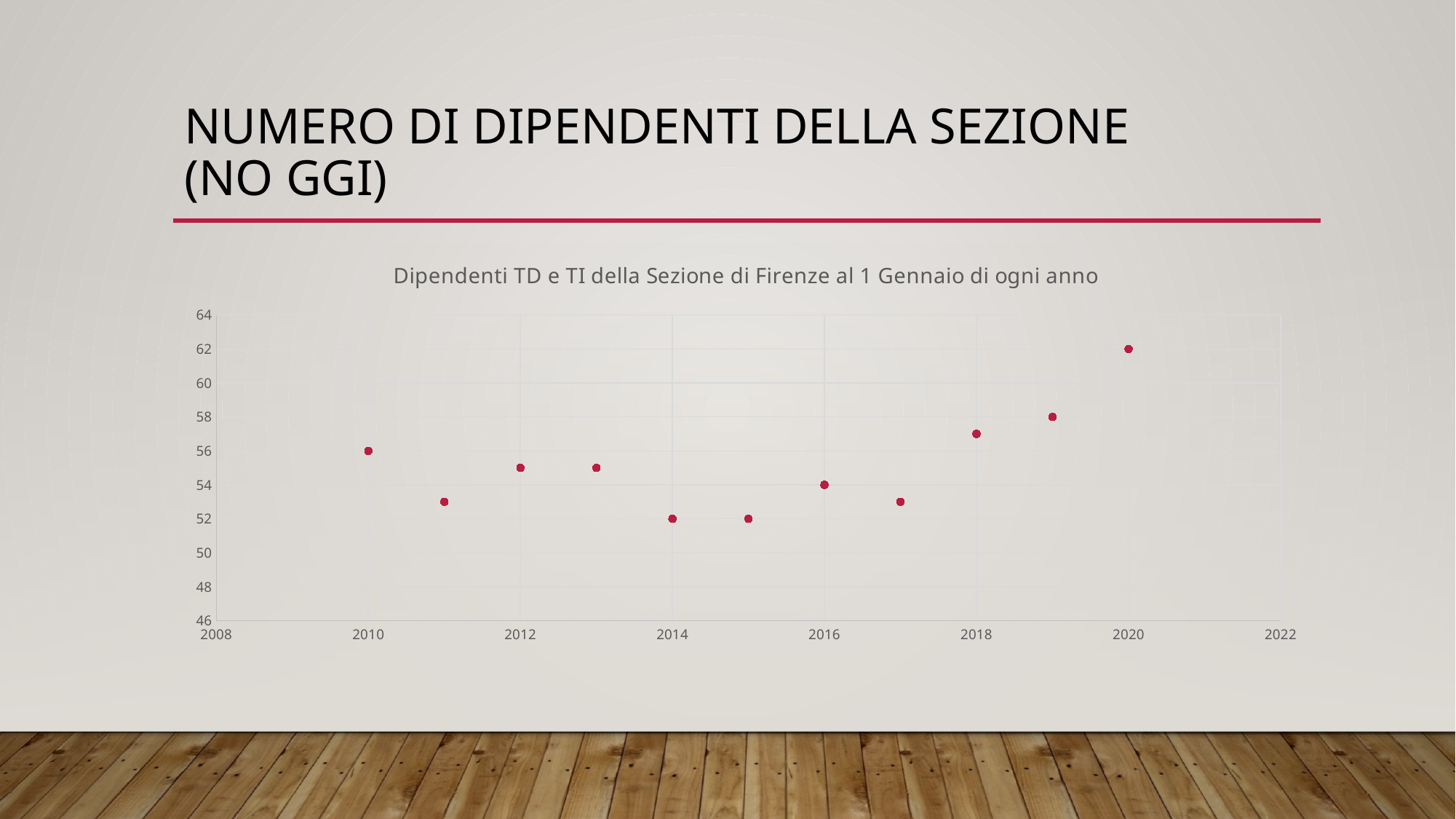
Which is larger, the value for 2020 or the value for 2010? 2020 Do the values rise or fall from 2016 to 2020? rise What is the difference between the values for 2020 and 2010? 6 What is the title of the chart? Dipendenti TD e TI della Sezione di Firenze al 1 Gennaio di ogni anno Which year has the highest value? 2020 What is the value for 2020? 62 What is the value for 2019? 58 How many data points are plotted in the chart? 11 What is the value for 2016? 54 Is the value for 2011 greater or less than 54? less What is the value for 2010? 56 What type of chart is shown on the slide? Scatter chart